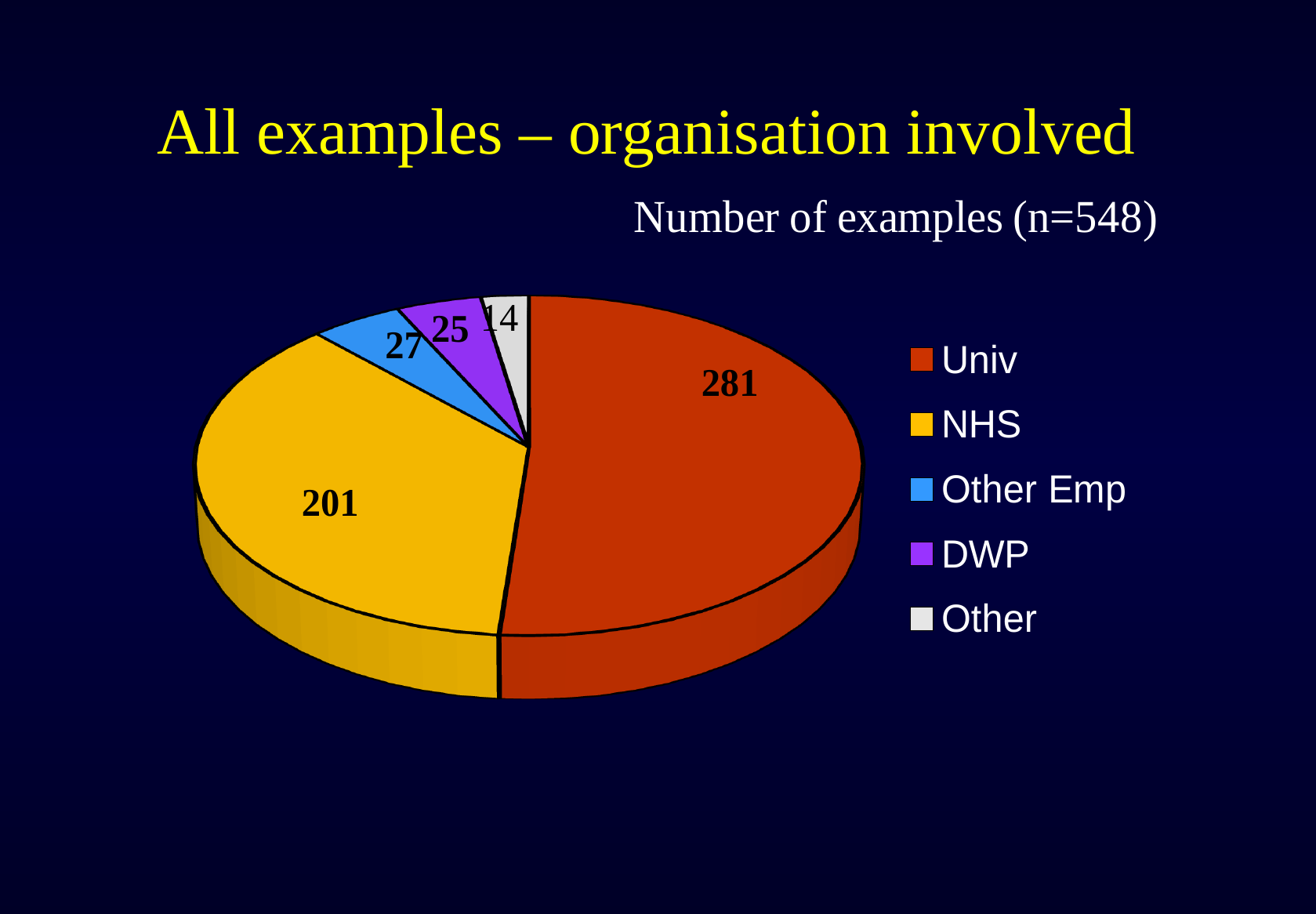
Which is larger, the NHS slice or the Univ slice? Univ How many examples involved a university (Univ)? 281 What is the difference between the Univ and NHS values? 80 Which organisation has the largest slice of the pie? Univ What is the value shown for Other Emp? 27 How many categories does the pie chart show? 5 What is the value shown for the NHS slice? 201 What type of chart is shown on the slide? Pie chart According to the chart subtitle, what is the total number of examples (n)? 548 What is the difference between the Other Emp and DWP values? 2 How many examples involved DWP? 25 Which organisation has the smallest slice of the pie? Other